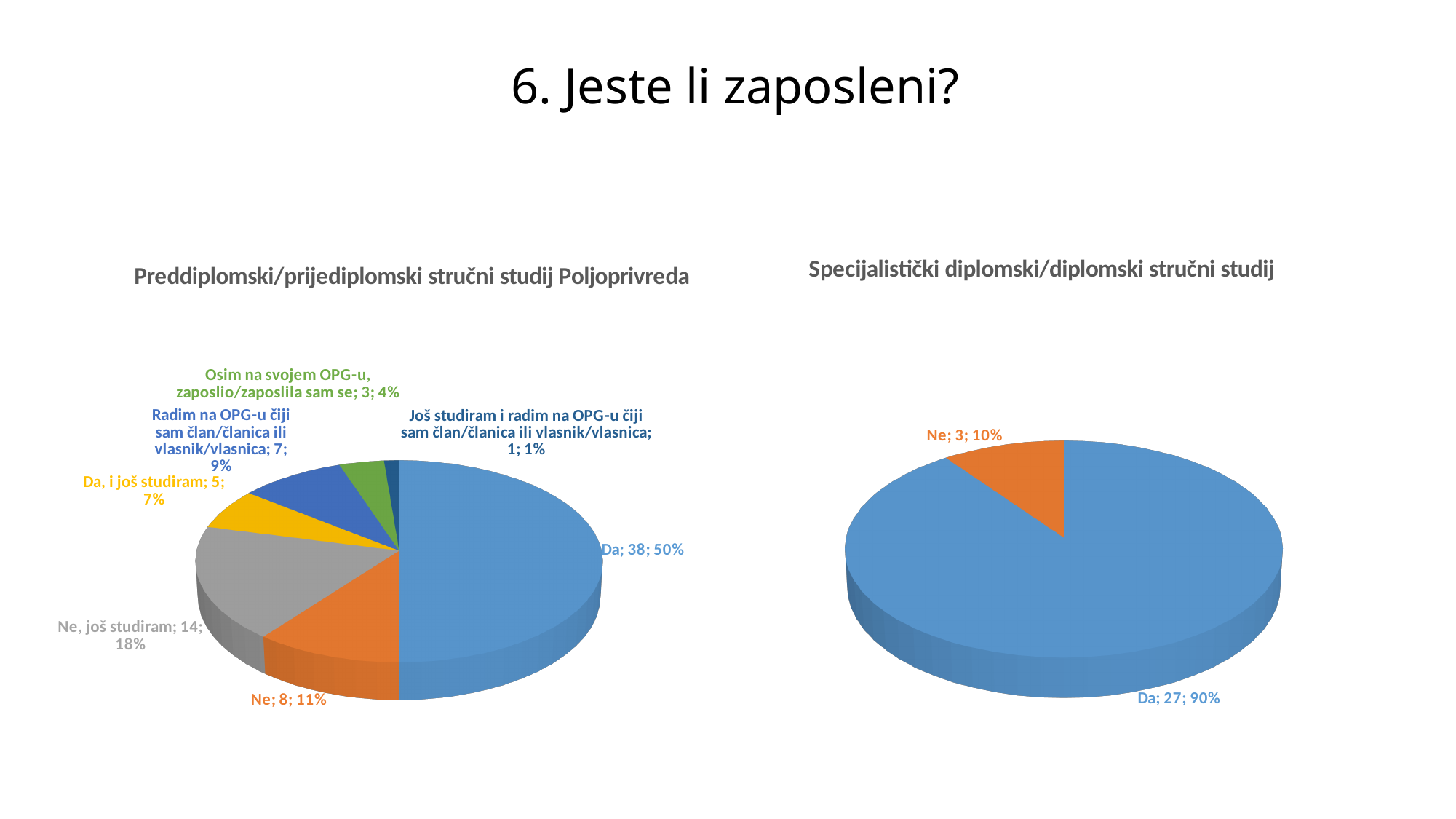
What kind of chart is used on the left, titled "Preddiplomski/prijediplomski stručni studij Poljoprivreda"? Pie chart In the left chart (Preddiplomski/prijediplomski stručni studij Poljoprivreda), which is larger: "Da, i još studiram" or "Radim na OPG-u čiji sam član/članica ili vlasnik/vlasnica"? Radim na OPG-u čiji sam član/članica ili vlasnik/vlasnica In the left chart (Preddiplomski/prijediplomski stručni studij Poljoprivreda), what share of the pie is "Ne, još studiram"? 18% In the left chart (Preddiplomski/prijediplomski stručni studij Poljoprivreda), which category has the smallest slice? Još studiram i radim na OPG-u čiji sam član/članica ili vlasnik/vlasnica What is the title of the slide? 6. Jeste li zaposleni? In the left chart (Preddiplomski/prijediplomski stručni studij Poljoprivreda), which category has the largest slice? Da In the left chart (Preddiplomski/prijediplomski stručni studij Poljoprivreda), how many respondents answered "Da"? 38 How many categories are shown in the left chart (Preddiplomski/prijediplomski stručni studij Poljoprivreda)? 7 In the right chart (Specijalistički diplomski/diplomski stručni studij), what share of the pie is "Ne"? 10% How many categories are shown in the right chart (Specijalistički diplomski/diplomski stručni studij)? 2 In the left chart (Preddiplomski/prijediplomski stručni studij Poljoprivreda), what is the difference in count between "Ne, još studiram" and "Ne"? 6 In the right chart (Specijalistički diplomski/diplomski stručni studij), how many respondents answered "Da"? 27